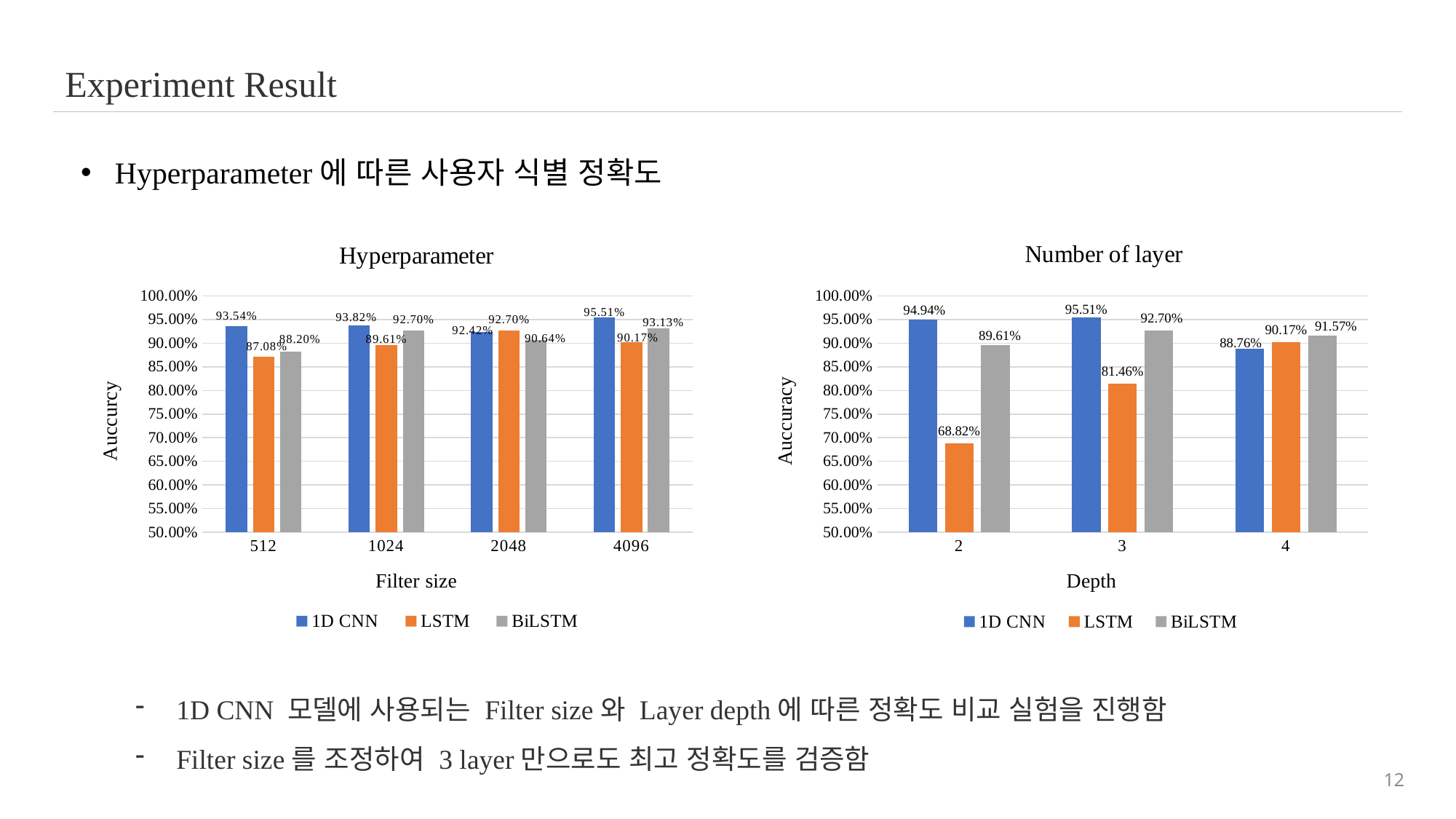
In the Hyperparameter chart, which is larger at filter size 2048: the 1D CNN accuracy or the LSTM accuracy? LSTM How many filter size categories are shown in the Hyperparameter chart? 4 In the Hyperparameter chart, which filter size gives the highest 1D CNN accuracy? 4096 In the Hyperparameter chart, what is the accuracy of 1D CNN at filter size 4096? 95.51% How many series does the legend of the Number of layer chart list? 3 In the Number of layer chart, is the LSTM accuracy at depth 2 greater or less than 70.00%? less What type of chart is the Number of layer chart? bar chart In the Hyperparameter chart, what is the accuracy of LSTM at filter size 512? 87.08% In the Number of layer chart, what is the accuracy of BiLSTM at depth 4? 91.57% In the Number of layer chart, which depth gives the lowest LSTM accuracy? 2 In the Number of layer chart, what is the difference between the 1D CNN and LSTM accuracies at depth 3? 14.05% In the Number of layer chart, what is the accuracy of LSTM at depth 2? 68.82%